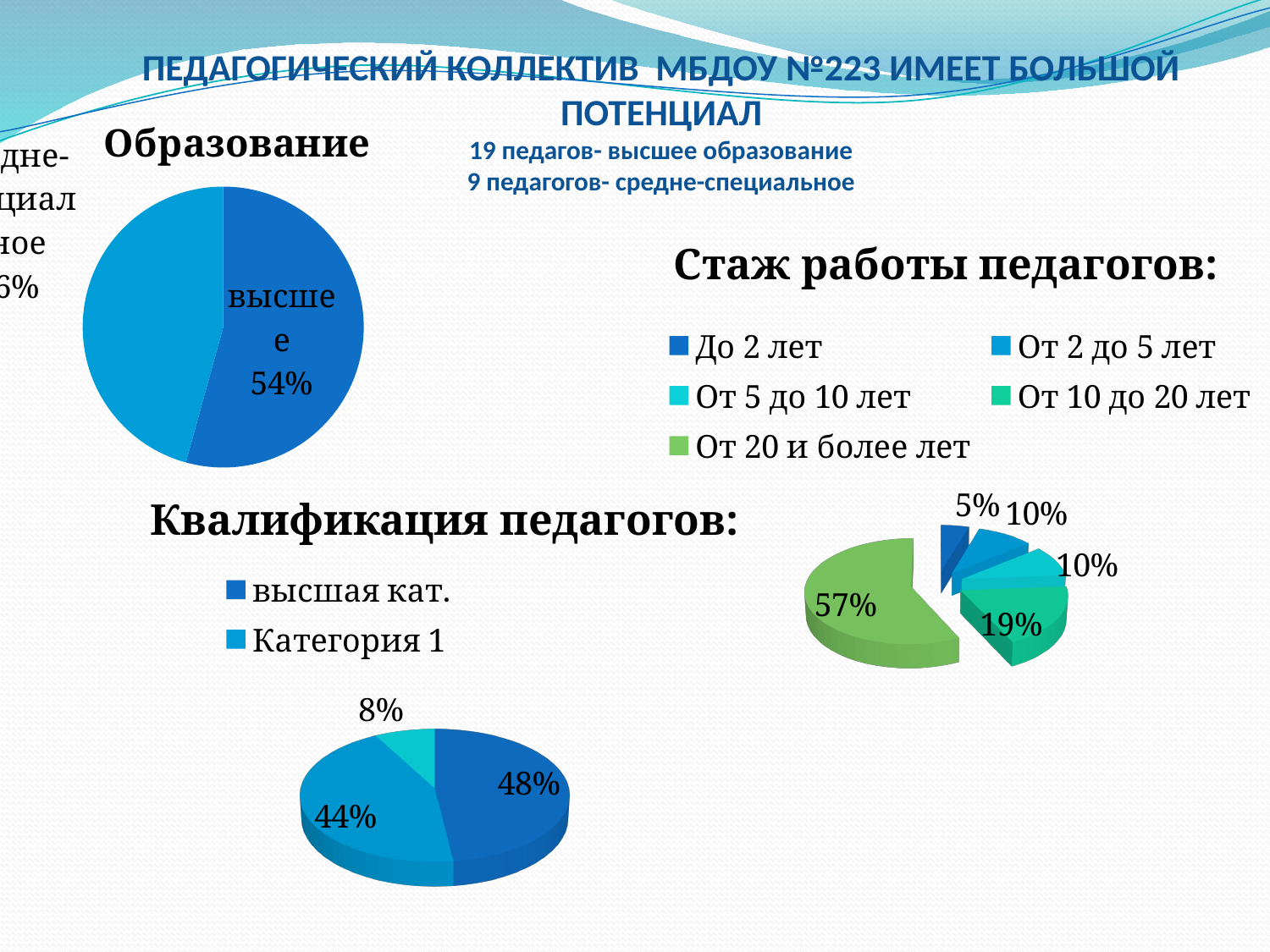
What kind of chart is the 'Образование' chart? pie chart How many categories does the legend of the 'Стаж работы педагогов' chart list? 5 In the 'Квалификация педагогов' chart, what is the value for 'высшая кат.'? 48% In the 'Квалификация педагогов' chart, what is the value for 'Категория 1'? 44% In the 'Образование' pie chart, what share is labelled 'высшее'? 54% In the 'Стаж работы педагогов' chart, what is the value for 'До 2 лет'? 5% In the 'Стаж работы педагогов' chart, which category has the largest share? От 20 и более лет In the 'Стаж работы педагогов' chart, what is the value for 'От 20 и более лет'? 57% In the 'Стаж работы педагогов' chart, which category has the smallest share? До 2 лет In the 'Стаж работы педагогов' chart, what is the value for 'От 10 до 20 лет'? 19% In the 'Стаж работы педагогов' chart, what is the difference between 'От 20 и более лет' and 'От 10 до 20 лет'? 38% In the 'Квалификация педагогов' chart, which is larger: 'высшая кат.' or 'Категория 1'? высшая кат.